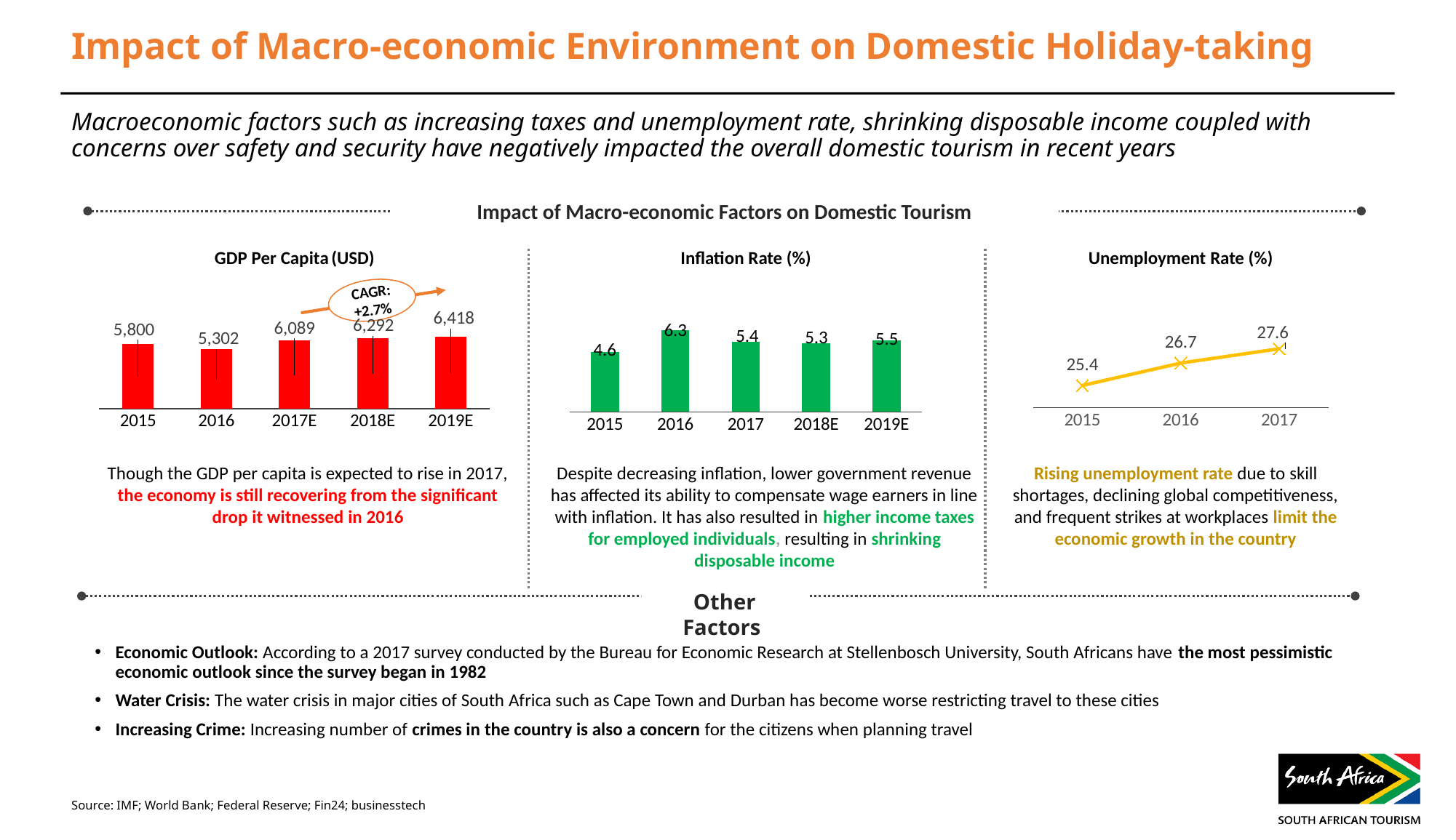
In the Unemployment Rate (%) chart, what is the value for 2017? 27.6 In the GDP Per Capita (USD) chart, what is the value for 2016? 5,302 In the Unemployment Rate (%) chart, do the values rise or fall from 2015 to 2017? rise In the GDP Per Capita (USD) chart, which year has the lowest value? 2016 In the GDP Per Capita (USD) chart, which year has the highest value? 2019E In the GDP Per Capita (USD) chart, how many years are shown? 5 In the Inflation Rate (%) chart, which year has the lowest value? 2015 What kind of chart is the Inflation Rate (%) chart? bar chart In the GDP Per Capita (USD) chart, what is the difference between the 2019E and 2015 values? 618 In the Unemployment Rate (%) chart, what is the difference between the 2017 and 2015 values? 2.2 In the Inflation Rate (%) chart, what is the value for 2016? 6.3 In the Inflation Rate (%) chart, is the value for 2017 larger or smaller than the value for 2018E? larger